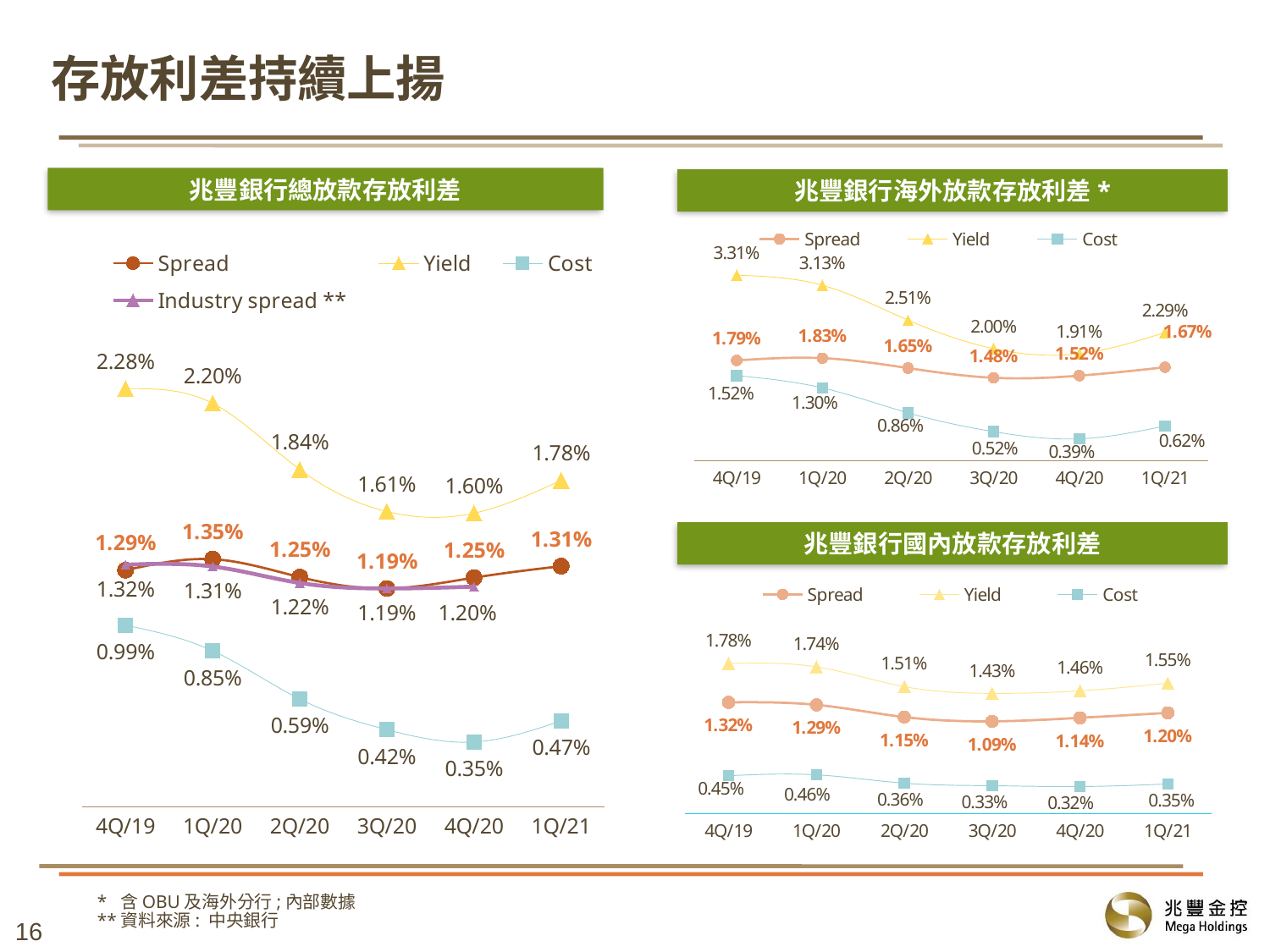
In the 兆豐銀行海外放款存放利差 * chart, what is the Cost value for 4Q/20? 0.39% In the 兆豐銀行總放款存放利差 chart, how many series does the legend list? 4 In the 兆豐銀行海外放款存放利差 * chart, in which quarter is Spread highest? 1Q/20 In the 兆豐銀行總放款存放利差 chart, what is the Yield value for 4Q/19? 2.28% In the 兆豐銀行國內放款存放利差 chart, how many quarters are shown on the x axis? 6 What kind of chart is the 兆豐銀行國內放款存放利差 chart? Line chart In the 兆豐銀行總放款存放利差 chart, what is the difference between the Yield and Cost values in 1Q/21? 1.31% In the 兆豐銀行總放款存放利差 chart, what is the Spread value for 1Q/21? 1.31% In the 兆豐銀行國內放款存放利差 chart, which is larger, the Yield value for 4Q/19 or the Yield value for 1Q/21? 4Q/19 In the 兆豐銀行國內放款存放利差 chart, what is the Spread value for 3Q/20? 1.09% In the 兆豐銀行總放款存放利差 chart, in which quarter is Cost lowest? 4Q/20 In the 兆豐銀行海外放款存放利差 * chart, what is the Yield value for 4Q/19? 3.31%